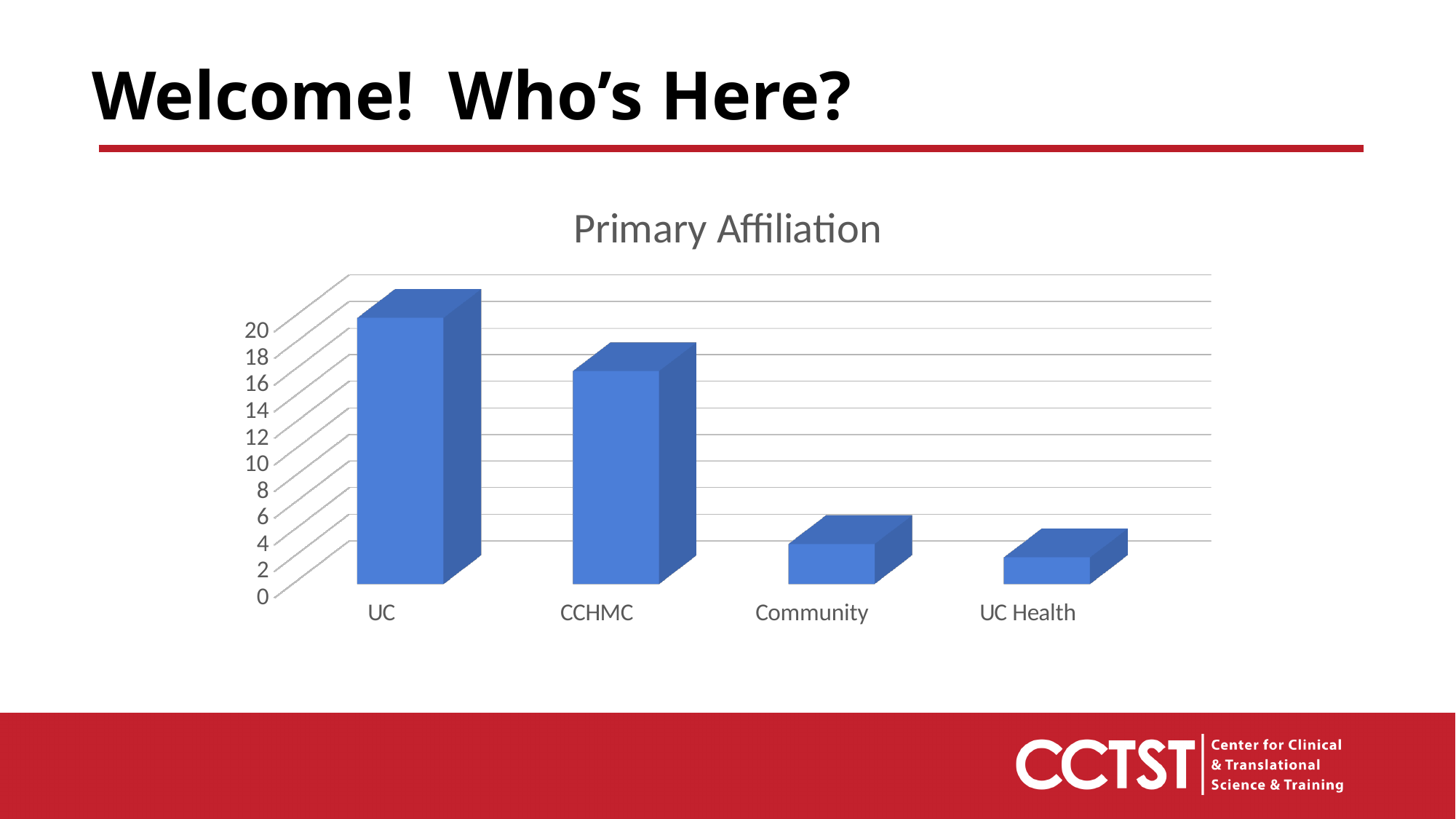
Is the value for Community greater or less than 10? less What is the title of the chart? Primary Affiliation Is the value for CCHMC greater or less than 10? greater What colour are the bars in the chart? blue Do the values rise or fall moving from left to right across the categories? fall Which category has the highest value in the Primary Affiliation chart? UC Is the value for UC greater or less than 10? greater How many categories are shown on the x axis of the chart? 4 What kind of chart is shown on the slide? bar chart Which is larger, the value for UC or the value for CCHMC? UC Which category has the lowest value in the Primary Affiliation chart? UC Health